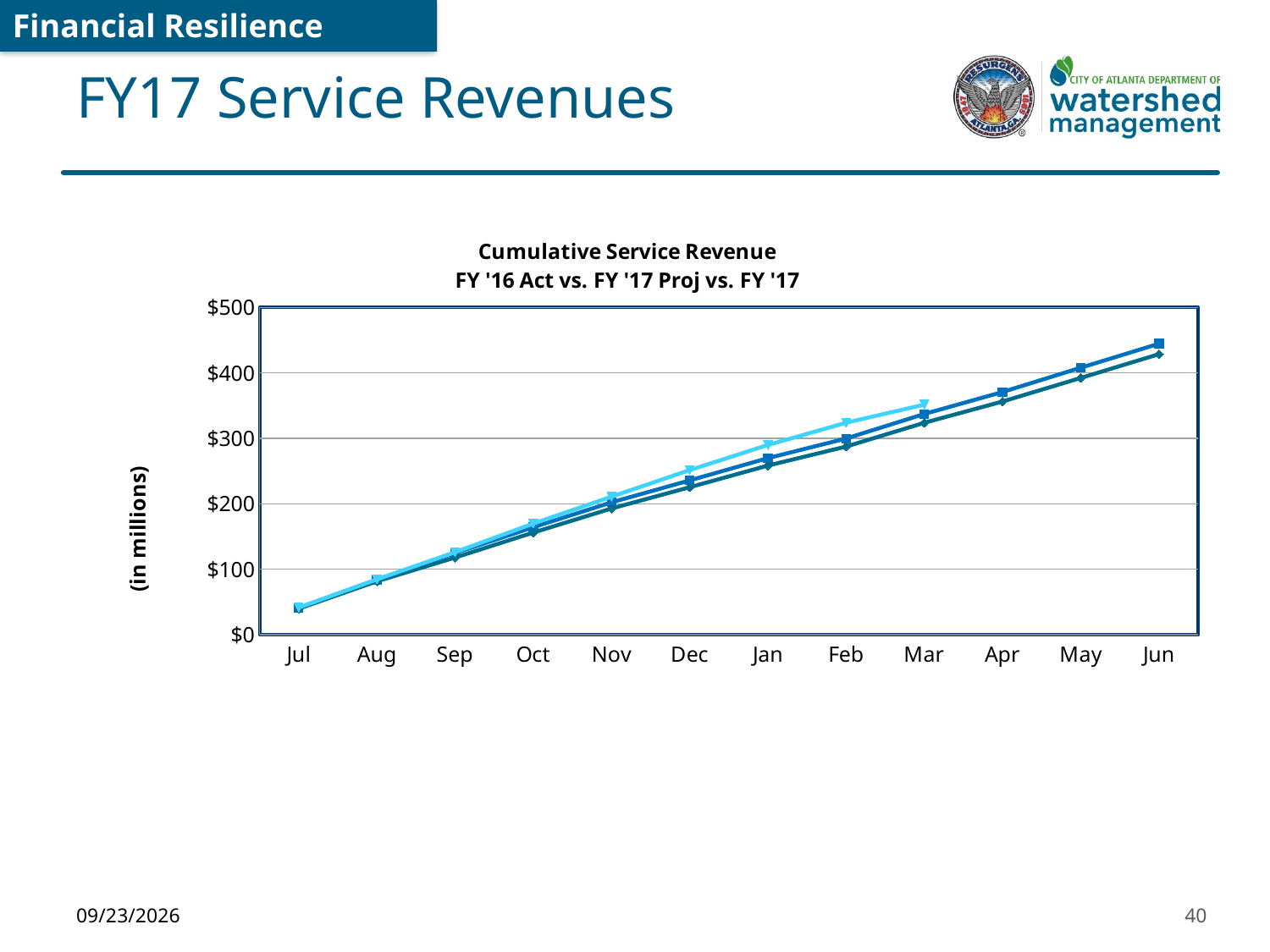
How many months are shown along the x axis of the chart? 12 What kind of chart is shown on the slide? line chart Are the values plotted for Sep greater or less than $200? less Are the values plotted for Dec greater or less than $300? less Which month has the highest plotted values on the chart? Jun Are the values plotted for Jun greater or less than $400? greater What unit label is shown on the vertical axis of the chart? (in millions) How many lines are plotted on the chart? 3 What is the title of the chart? Cumulative Service Revenue FY '16 Act vs. FY '17 Proj vs. FY '17 Do the plotted values rise or fall from Jul to Jun? rise